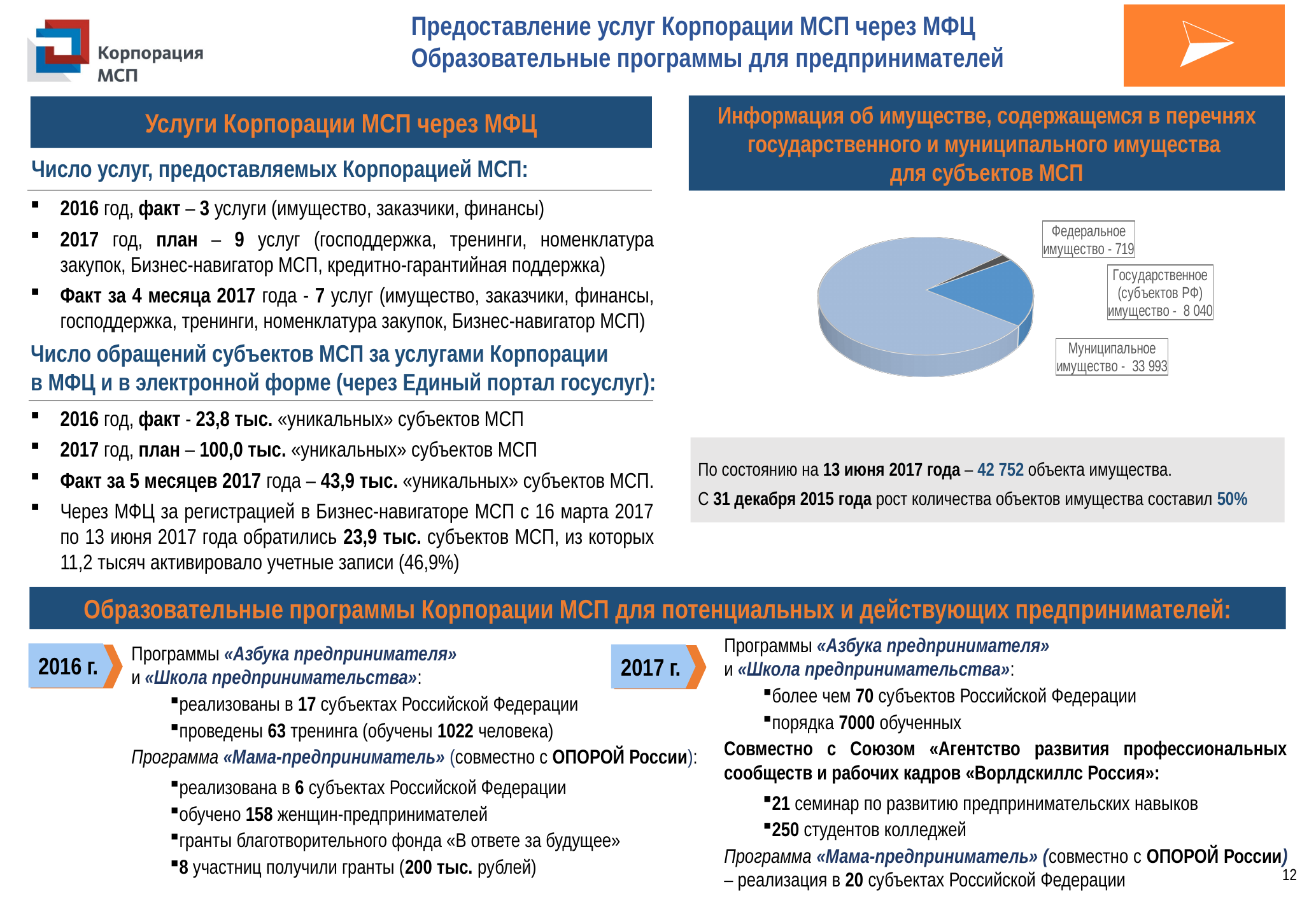
What is the difference between Муниципальное имущество and Государственное (субъектов РФ) имущество in the pie chart? 25 953 Which category has the smallest slice in the pie chart? Федеральное имущество Which is larger in the pie chart: Государственное (субъектов РФ) имущество or Федеральное имущество? Государственное (субъектов РФ) имущество What is the value for Федеральное имущество in the pie chart? 719 What is the value for Муниципальное имущество in the pie chart? 33 993 What kind of chart is shown on the slide? pie chart What is the difference between Государственное (субъектов РФ) имущество and Федеральное имущество in the pie chart? 7 321 Which category has the largest slice in the pie chart? Муниципальное имущество What is the value for Государственное (субъектов РФ) имущество in the pie chart? 8 040 What is the total of all three slices in the pie chart? 42 752 What is the title of the section containing the pie chart? Информация об имуществе, содержащемся в перечнях государственного и муниципального имущества для субъектов МСП How many slices does the pie chart have? 3